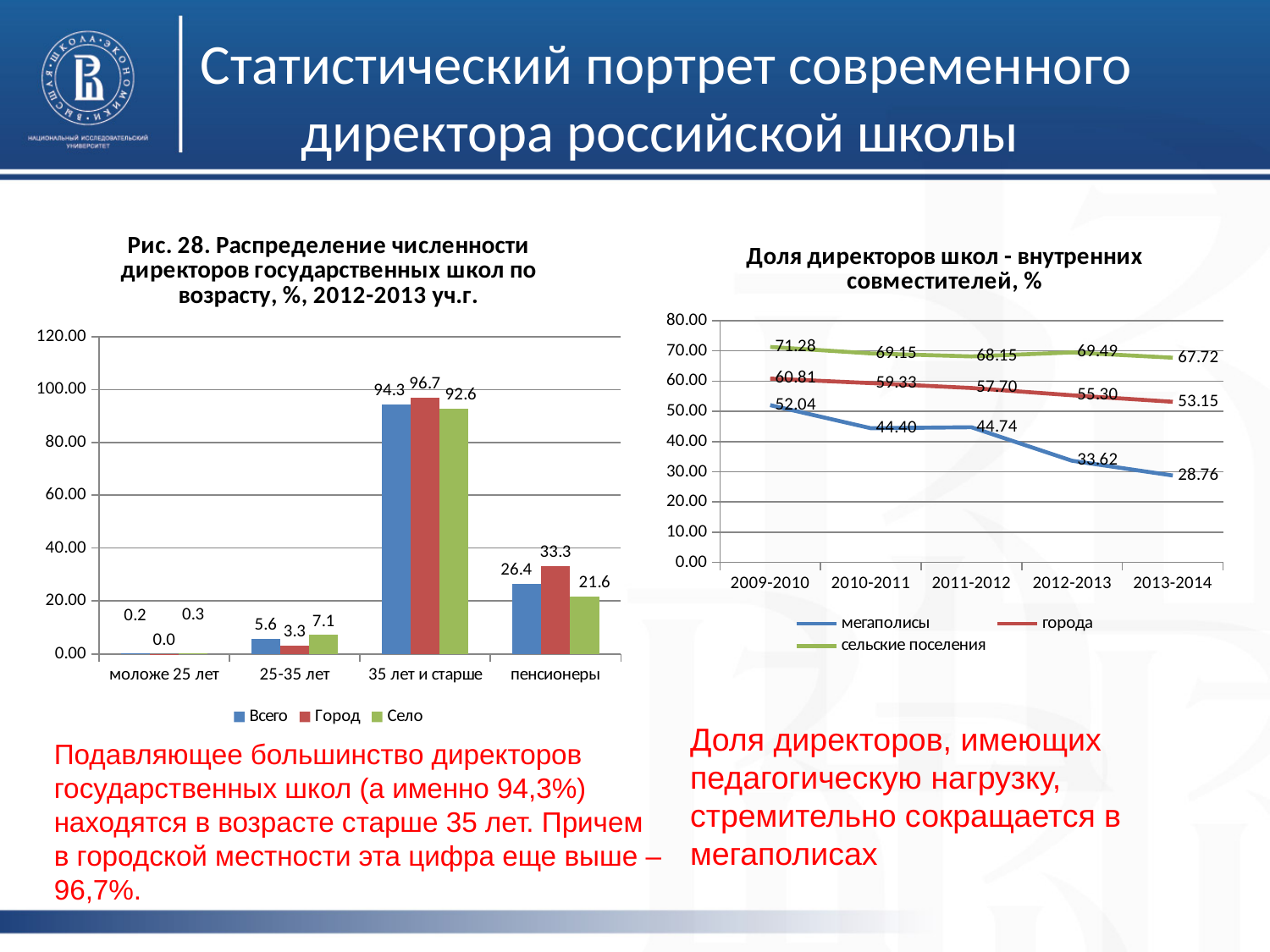
In the left chart (Рис. 28), what is the difference between the Город and Село values for 35 лет и старше? 4.1 In the right chart (Доля директоров школ - внутренних совместителей), what is the value for сельские поселения in 2009-2010? 71.28 In the left chart (Рис. 28), how many series does the legend list? 3 In the left chart (Рис. 28), which is larger for the category 25-35 лет: Всего or Село? Село In the right chart (Доля директоров школ - внутренних совместителей), what is the value for мегаполисы in 2013-2014? 28.76 In the left chart (Рис. 28), which category has the highest value for the Всего series? 35 лет и старше In the right chart (Доля директоров школ - внутренних совместителей), how many time periods are shown on the x axis? 5 In the left chart (Рис. 28), what is the value for Город in the category 35 лет и старше? 96.7 In the left chart (Рис. 28), what is the value for Село in the category пенсионеры? 21.6 In the right chart (Доля директоров школ - внутренних совместителей), what is the difference between the города values in 2009-2010 and 2013-2014? 7.66 In the right chart (Доля директоров школ - внутренних совместителей), does the мегаполисы series rise or fall from 2009-2010 to 2013-2014? Fall What kind of chart is the left chart (Рис. 28)? Bar chart